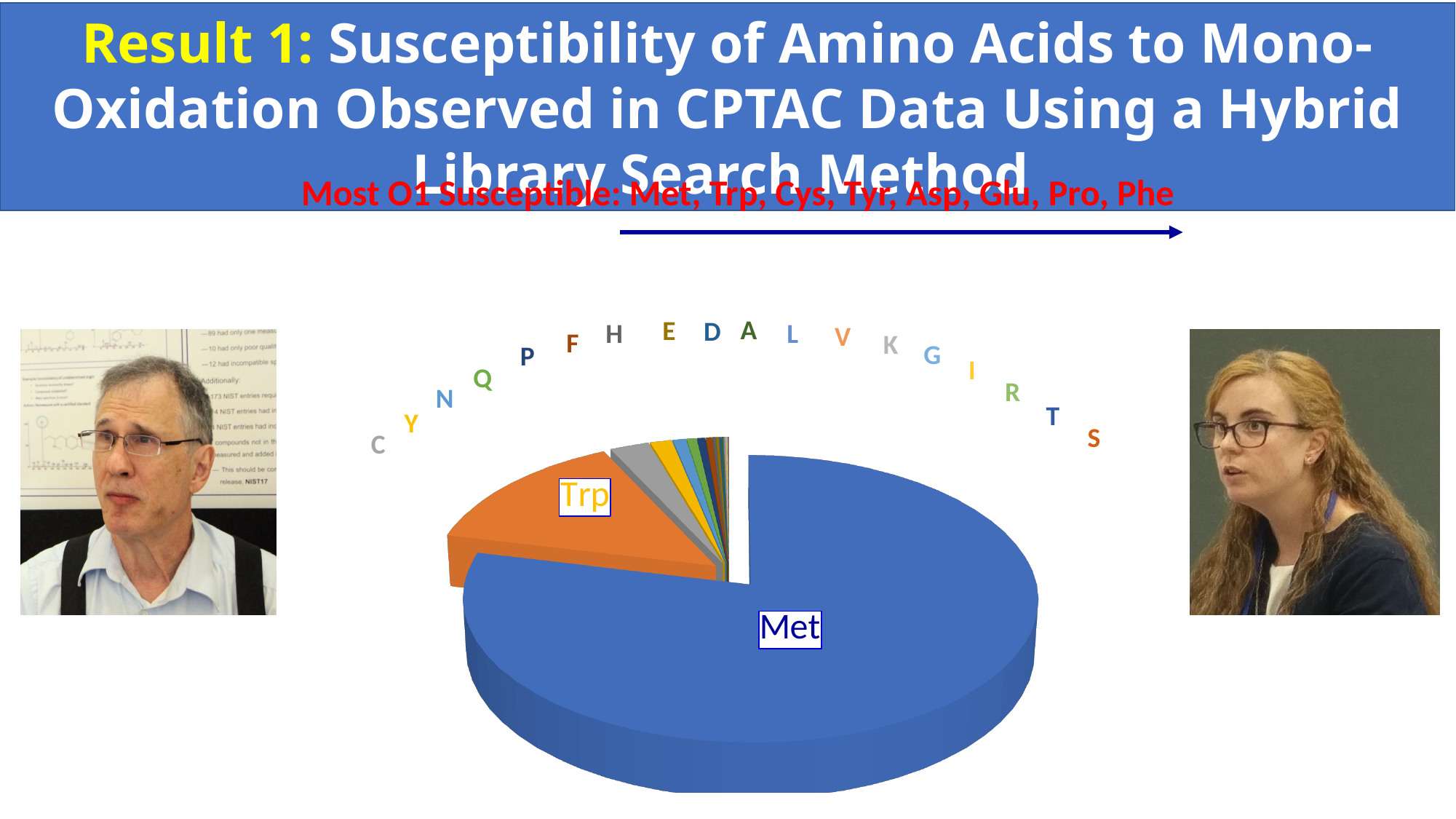
What colour is the Met slice in the pie chart? blue What kind of chart is shown on the slide? pie chart Which of the two labelled slices, Trp or Met, is the smaller one? Trp Which amino acid has the largest slice in the pie chart? Met What colour is the Trp slice in the pie chart? orange Which amino acid has the second-largest slice in the pie chart? Trp Does the Met slice take up more or less than half of the pie chart? more Which slice is larger in the pie chart, Met or Trp? Met